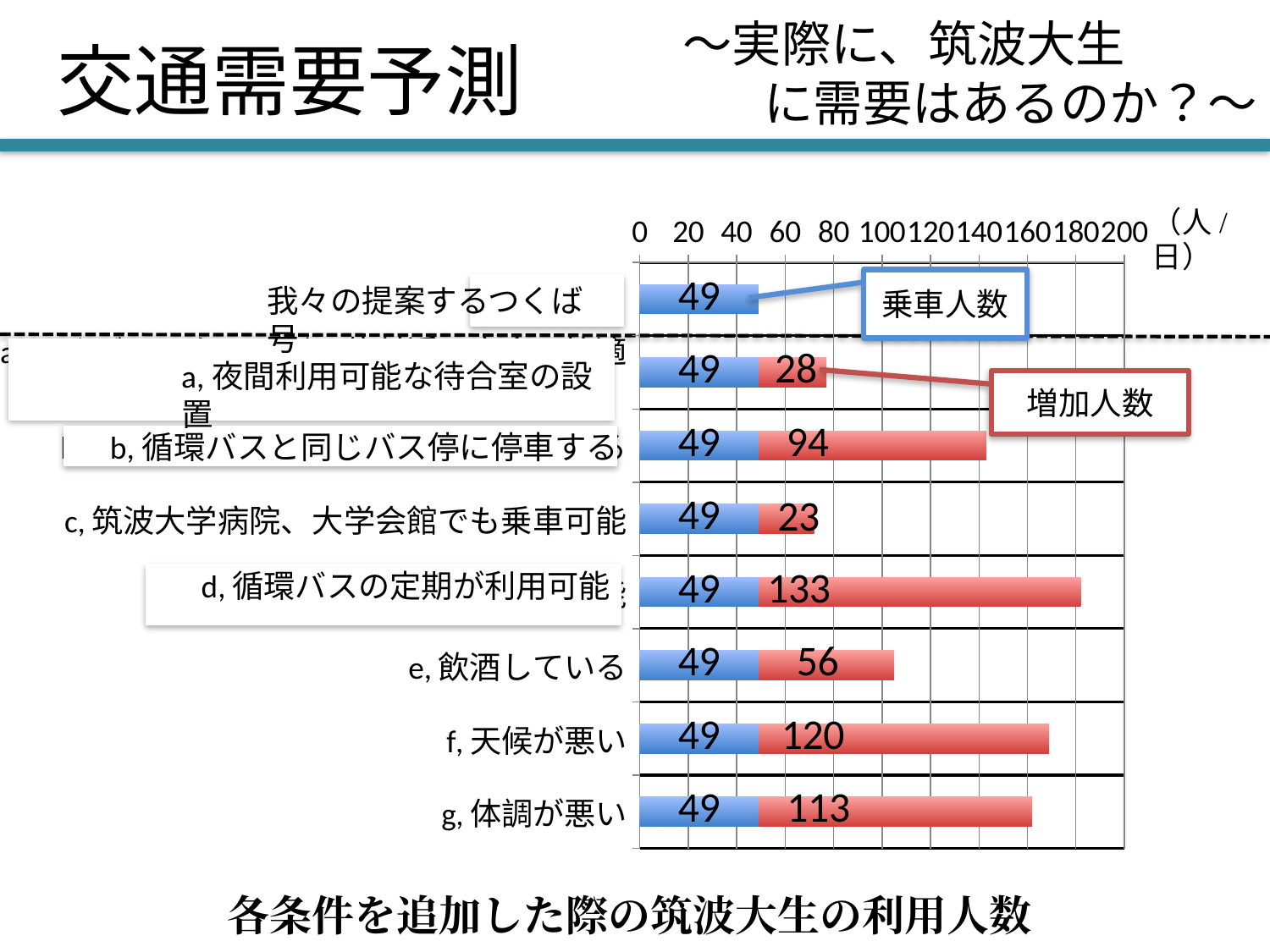
What is the difference between the 増加人数 values for d, 循環バスの定期が利用可能 and g, 体調が悪い? 20 What is the 増加人数 value for f, 天候が悪い? 120 What is the total of the stacked bar for a, 夜間利用可能な待合室の設置? 77 What kind of chart is shown on the slide? Stacked bar chart Which category has the highest 増加人数 value? d, 循環バスの定期が利用可能 How many series does the chart show? 2 Among the categories with a 増加人数 value, which has the lowest? c, 筑波大学病院、大学会館でも乗車可能 What is the total of the stacked bar for f, 天候が悪い? 169 How many categories are shown on the chart? 8 What is the 乗車人数 value for e, 飲酒している? 49 What is the 増加人数 value for c, 筑波大学病院、大学会館でも乗車可能? 23 Which has a larger 増加人数 value, b, 循環バスと同じバス停に停車する or e, 飲酒している? b, 循環バスと同じバス停に停車する